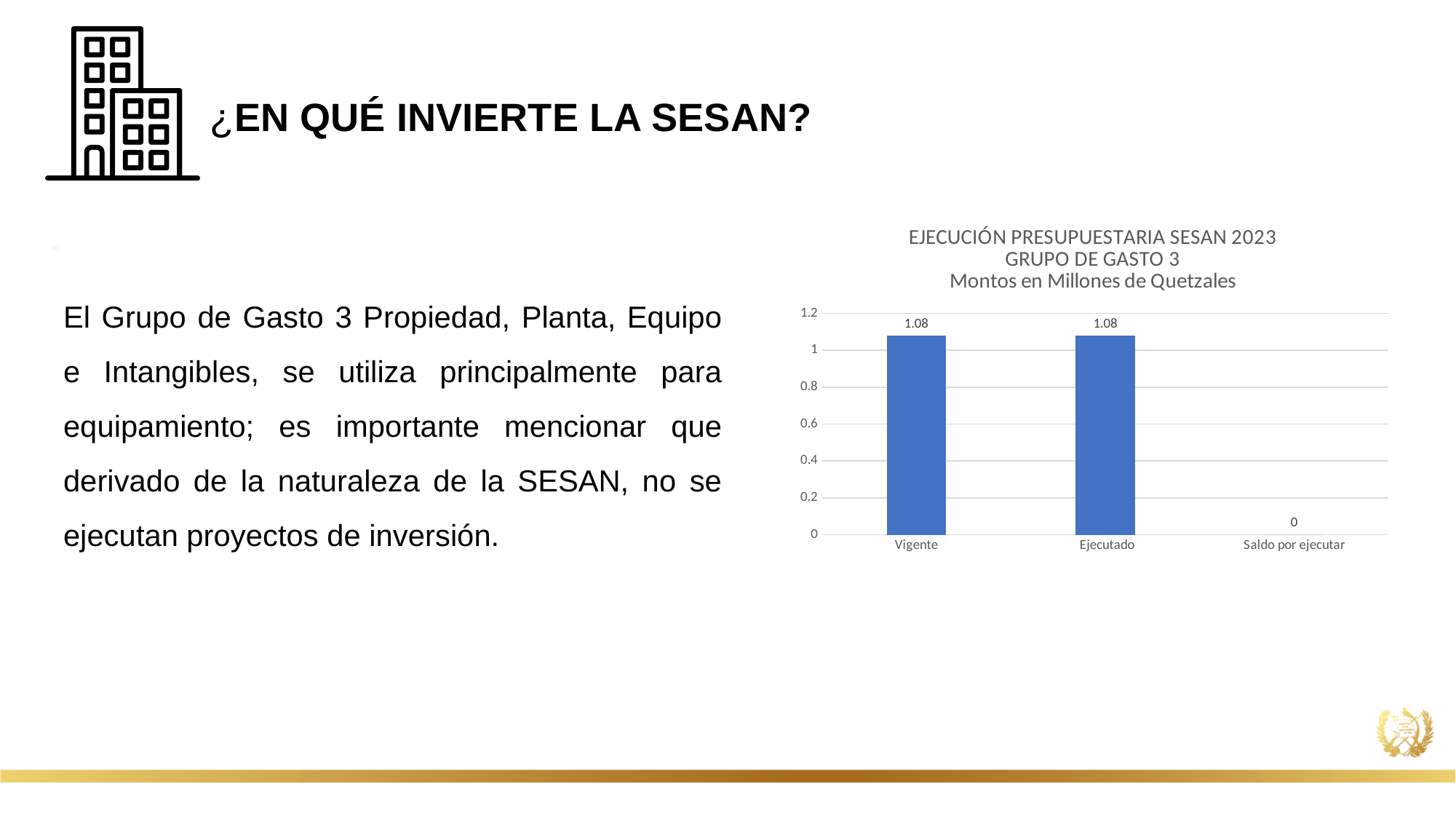
What is the title of the chart? EJECUCIÓN PRESUPUESTARIA SESAN 2023 GRUPO DE GASTO 3 Montos en Millones de Quetzales What is the value for Ejecutado? 1.08 What colour are the bars in the chart? blue Which is larger, the value for Vigente or the value for Saldo por ejecutar? Vigente What is the difference between the values for Vigente and Ejecutado? 0 What is the difference between the values for Ejecutado and Saldo por ejecutar? 1.08 Which category has the lowest value? Saldo por ejecutar What is the value for Saldo por ejecutar? 0 How many categories are shown on the x axis? 3 Is the value for Ejecutado greater or less than 1? greater What kind of chart is shown on the slide? bar chart What is the value for Vigente? 1.08